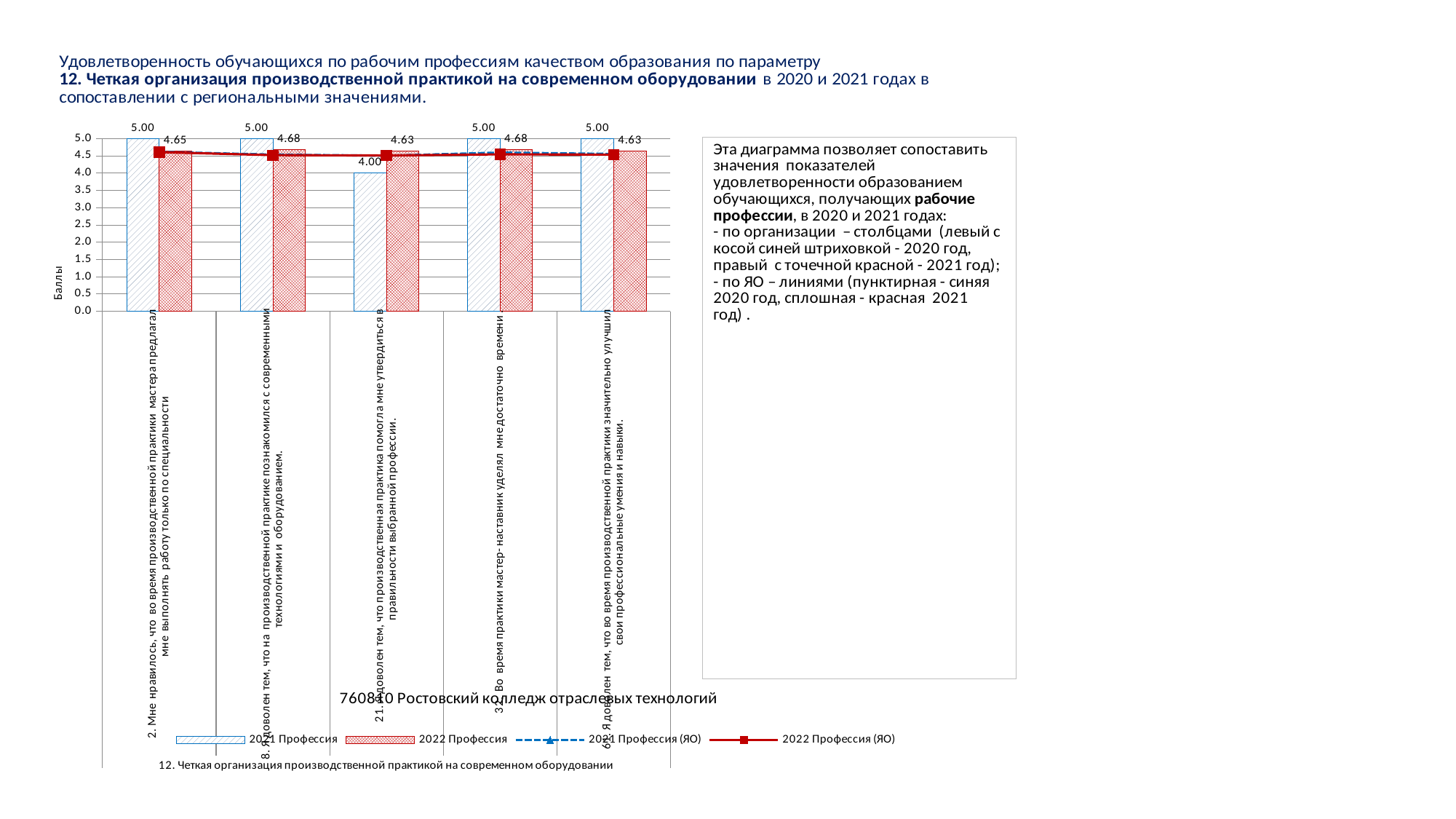
How many series does the chart legend list? 4 What is the value of the 2021 Профессия bar for statement 21 (производственная практика помогла мне утвердиться в правильности выбранной профессии)? 4.00 What is the value of the 2021 Профессия bar for statement 2 (мастер предлагал мне выполнять работу только по специальности)? 5.00 How many categories (survey statements) are plotted on the x axis? 5 What is the title of the vertical axis? Баллы What kind of chart is shown on the slide? Bar chart with line series For which statement is the 2021 Профессия bar the lowest? 21. Я доволен тем, что производственная практика помогла мне утвердиться в правильности выбранной профессии Is the 2022 Профессия bar for statement 21 greater or less than 4.0? greater What is the difference between the 2021 Профессия bars for statement 2 and statement 21? 1.00